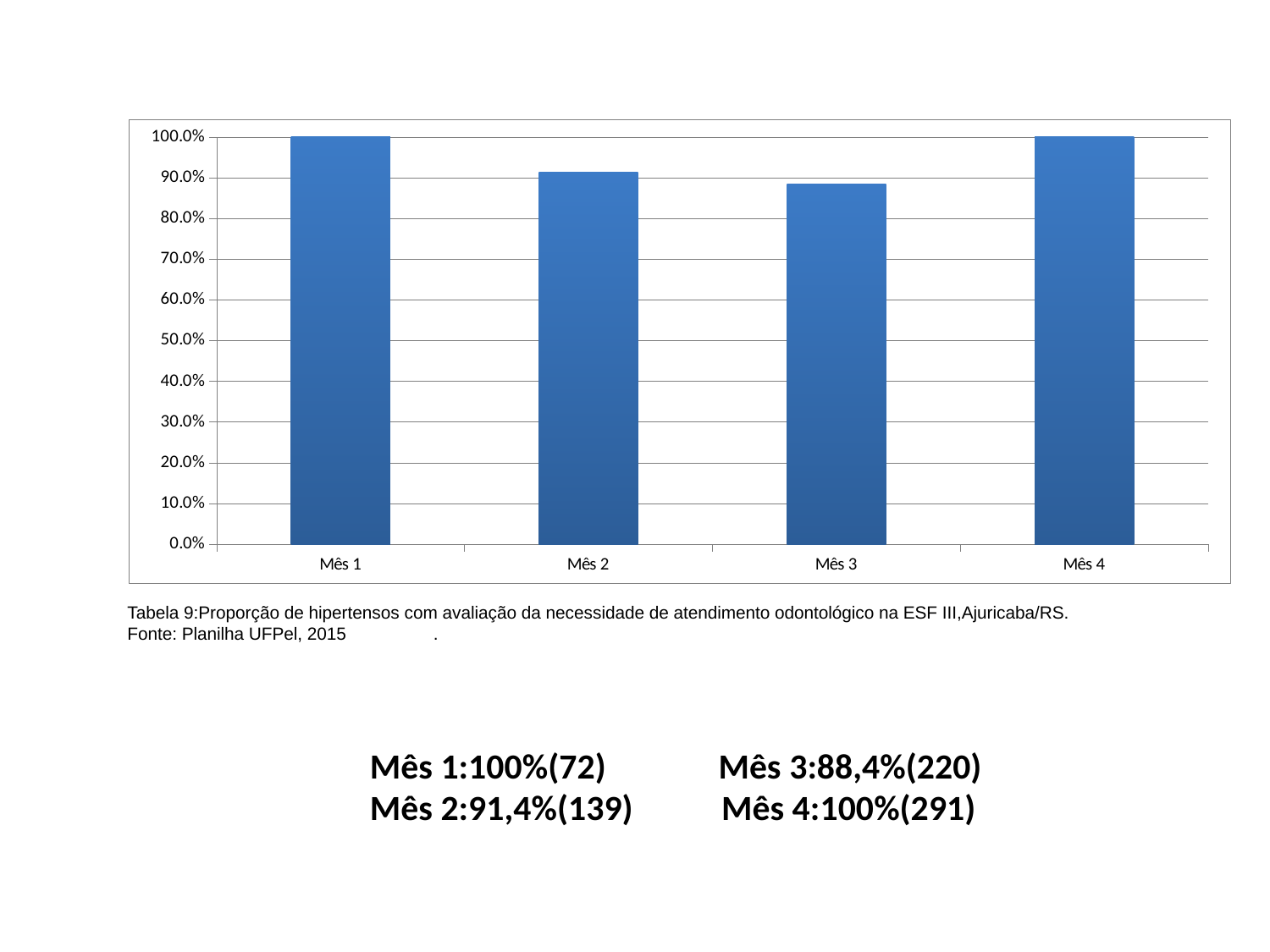
How many months are shown on the x axis? 4 What is the value for Mês 3? 88,4% Which month has the lowest value? Mês 3 What kind of chart is shown on the slide? bar chart What is the difference between the values for Mês 1 and Mês 2? 8,6% What is the value for Mês 2? 91,4% Is the value for Mês 3 greater or less than 90.0%? less According to the caption, what is the source of the data? Planilha UFPel, 2015 Which months share the highest value of 100%? Mês 1 and Mês 4 Which is larger, the value for Mês 2 or the value for Mês 3? Mês 2 What is the value for Mês 1? 100% What is the difference between the values for Mês 2 and Mês 3? 3,0%